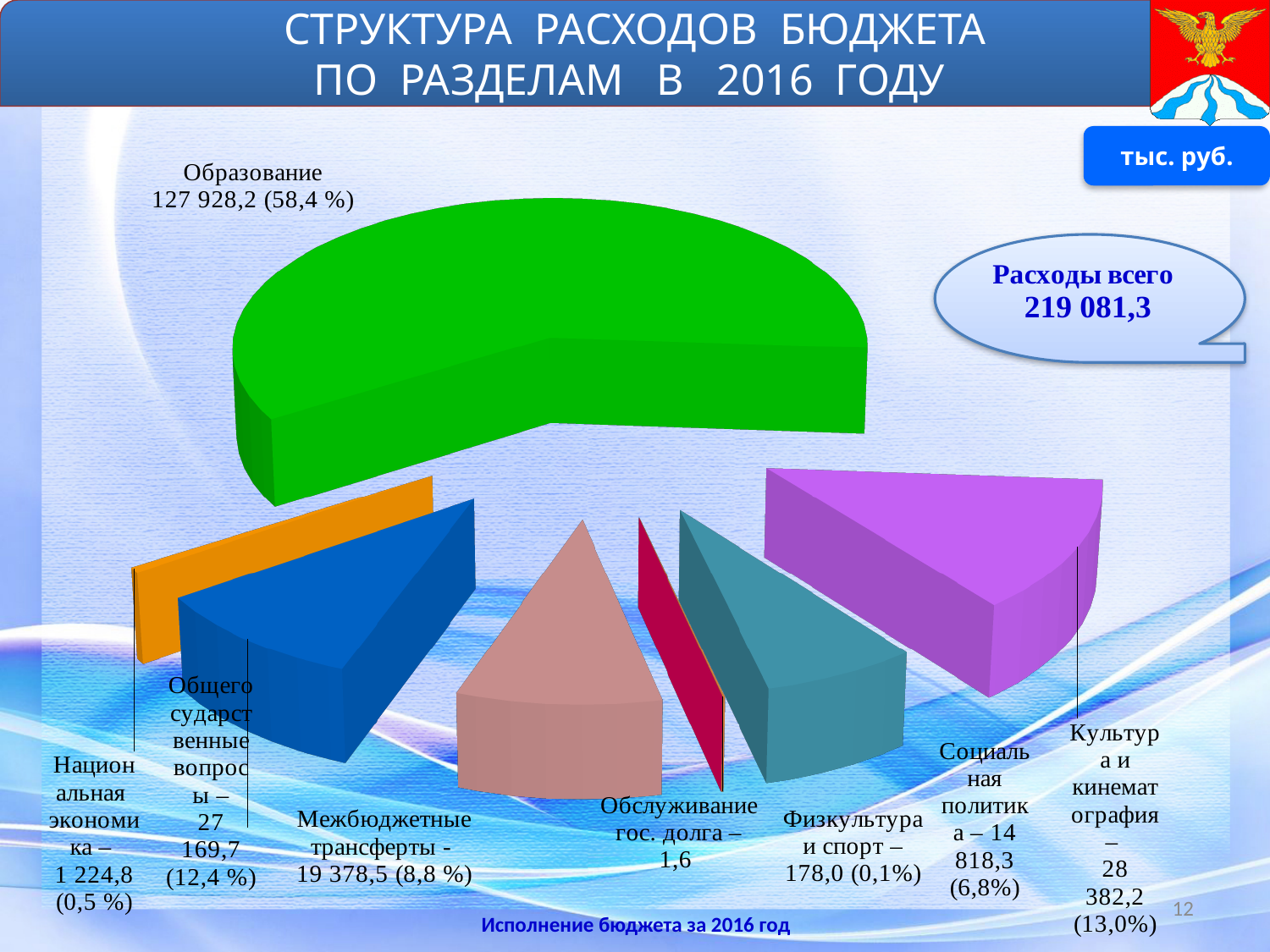
What is the value for Социальная политика? 14 818,3 How many categories are shown in the pie chart? 8 What total expenditure (Расходы всего) is shown on the slide? 219 081,3 Which is larger, Межбюджетные трансферты or Социальная политика? Межбюджетные трансферты What is the value for Культура и кинематография? 28 382,2 What share of the pie does Образование represent? 58,4 % What is the difference between the values for Культура и кинематография and Общегосударственные вопросы? 1 212,5 Which category has the smallest value? Обслуживание гос. долга What is the value for Образование? 127 928,2 Which category has the largest slice of the pie? Образование What type of chart is shown on the slide? pie chart What share of the pie does Общегосударственные вопросы represent? 12,4 %